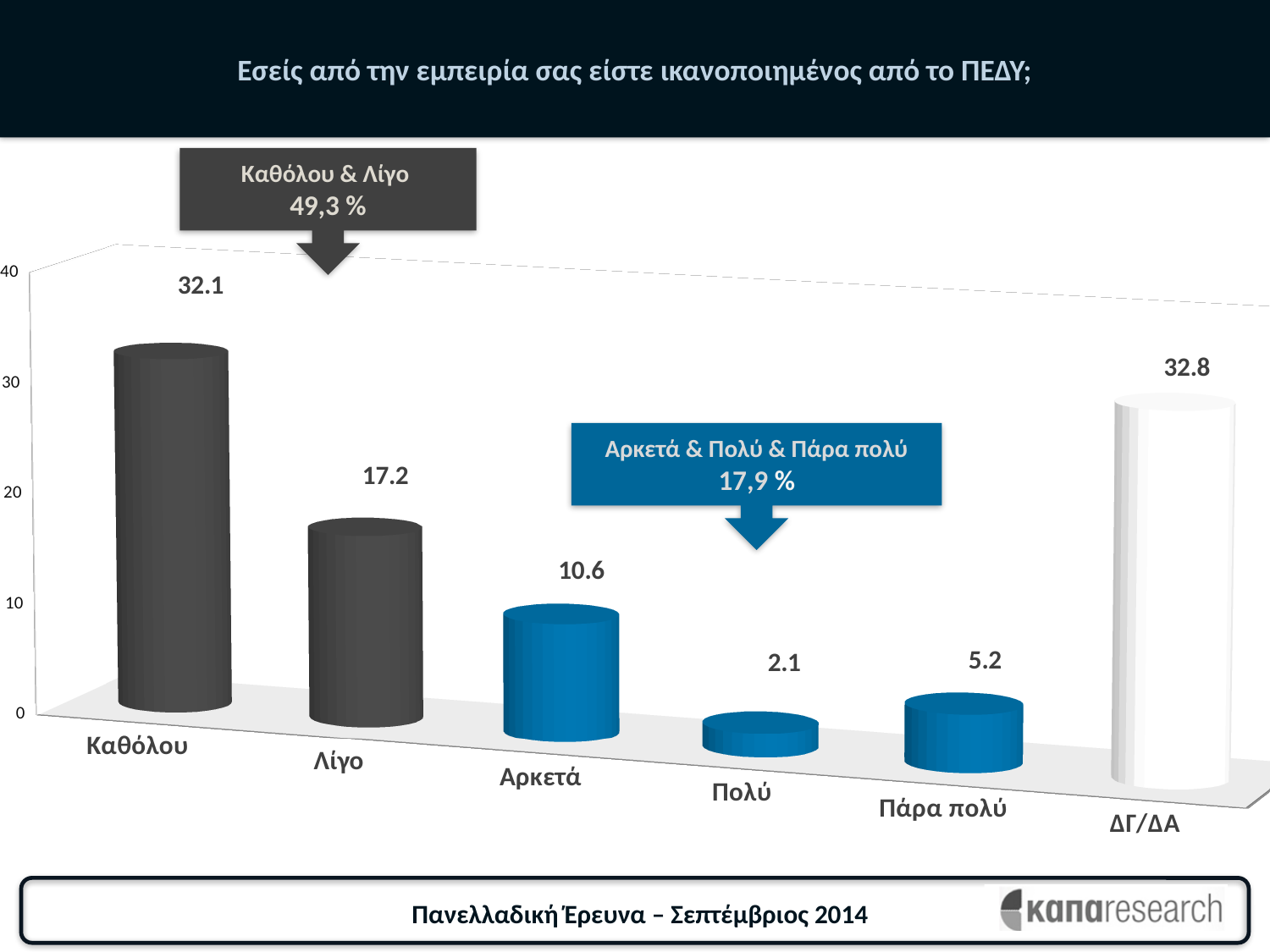
What is the value for Πάρα πολύ? 5.2 What is the value for Καθόλου? 32.1 What is the value for Λίγο? 17.2 What combined percentage does the slide give for Καθόλου & Λίγο? 49,3 % What is the value for Αρκετά? 10.6 Which is larger, the value for Αρκετά or the value for Πάρα πολύ? Αρκετά What kind of chart is shown on the slide? Bar chart How many categories are shown on the chart? 6 Which category has the lowest value? Πολύ What combined percentage does the slide give for Αρκετά & Πολύ & Πάρα πολύ? 17,9 % What is the difference between the values for Καθόλου and Λίγο? 14.9 Which category has the highest value? ΔΓ/ΔΑ